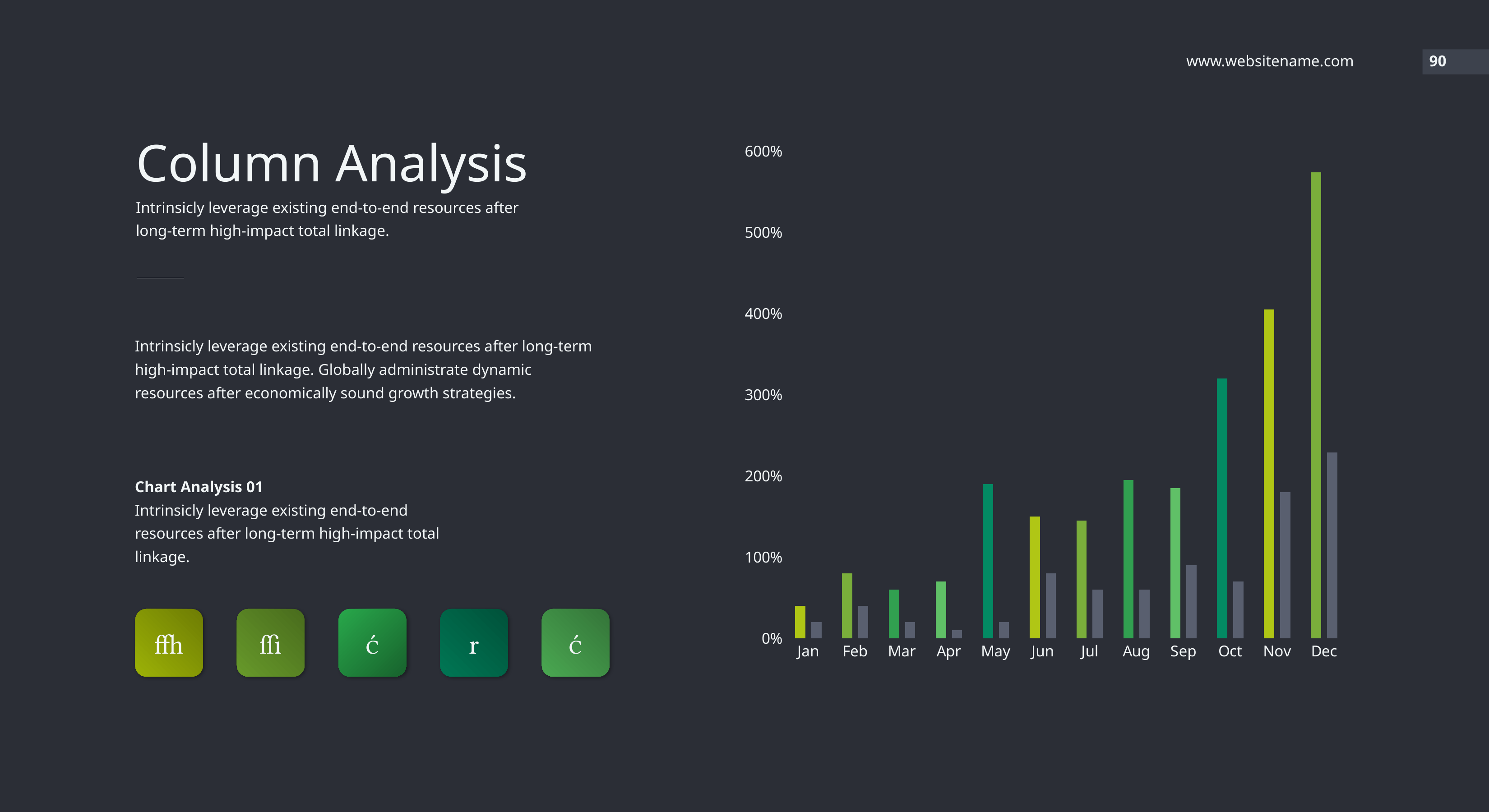
Which is taller, the green bar for Nov or the green bar for Oct? Nov How many months are shown on the x axis of the chart? 12 What is the highest value labelled on the y axis of the chart? 600% Which month has the shortest green bar? Jan What kind of chart is shown on the slide? bar chart Is the green bar for Dec greater or less than 500%? greater Which month has the tallest grey bar? Dec Do the green bars generally rise or fall from Jan to Dec? rise Which month has the tallest green bar? Dec Is the green bar for Oct greater or less than 300%? greater Is the grey bar for Nov greater or less than 200%? less